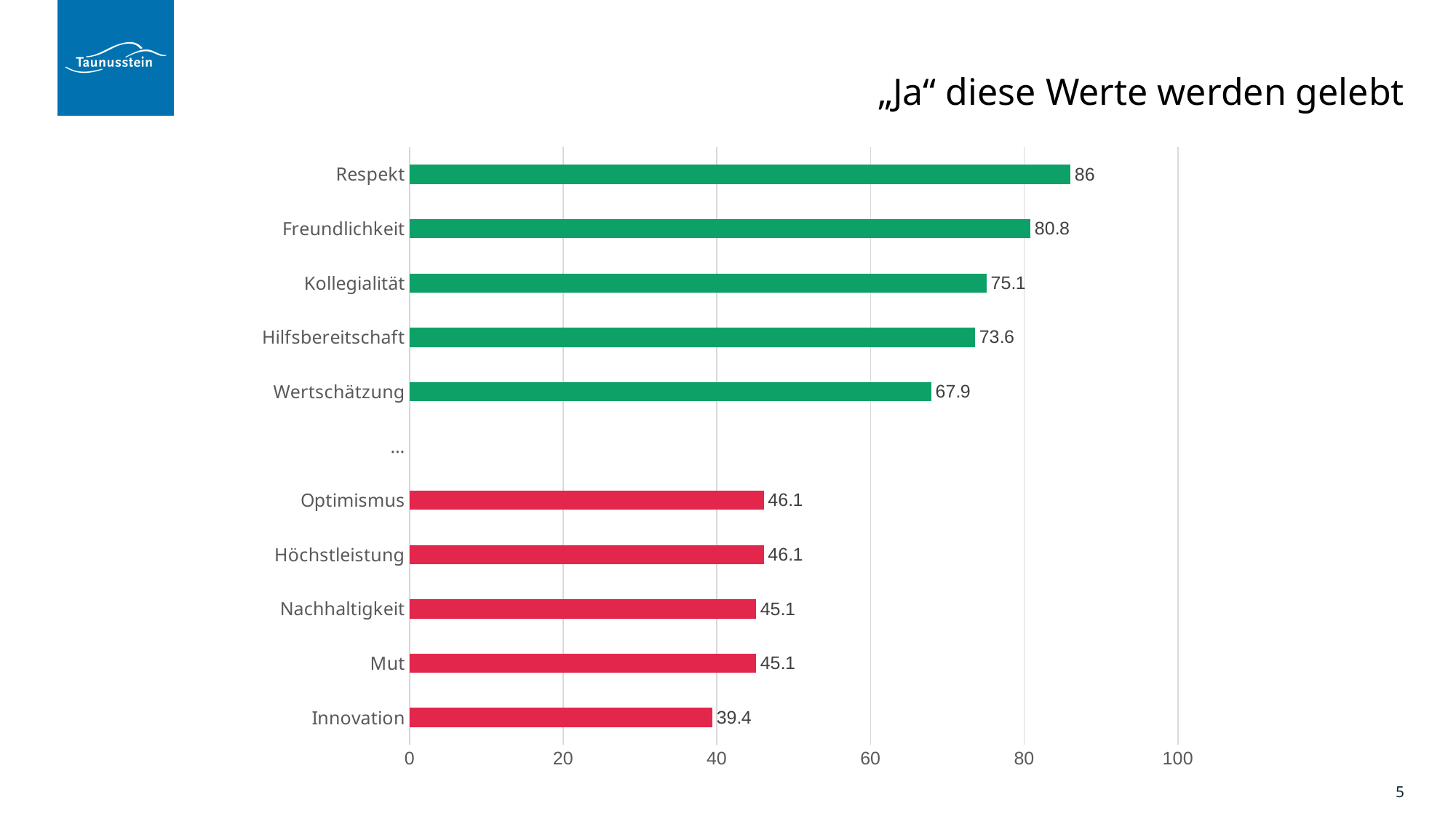
What is the difference between the values for Respekt and Innovation? 46.6 What is the difference between the values for Freundlichkeit and Kollegialität? 5.7 Which category has the lowest value? Innovation Which category has the highest value? Respekt How many labelled bars are plotted in the chart? 10 Which is larger, the value for Kollegialität or the value for Optimismus? Kollegialität What is the value for Hilfsbereitschaft? 73.6 What is the value for Innovation? 39.4 What kind of chart is shown on the slide? Bar chart What colour are the bars for Optimismus, Höchstleistung, Nachhaltigkeit, Mut and Innovation? Red What is the value for Wertschätzung? 67.9 What is the value for Respekt? 86